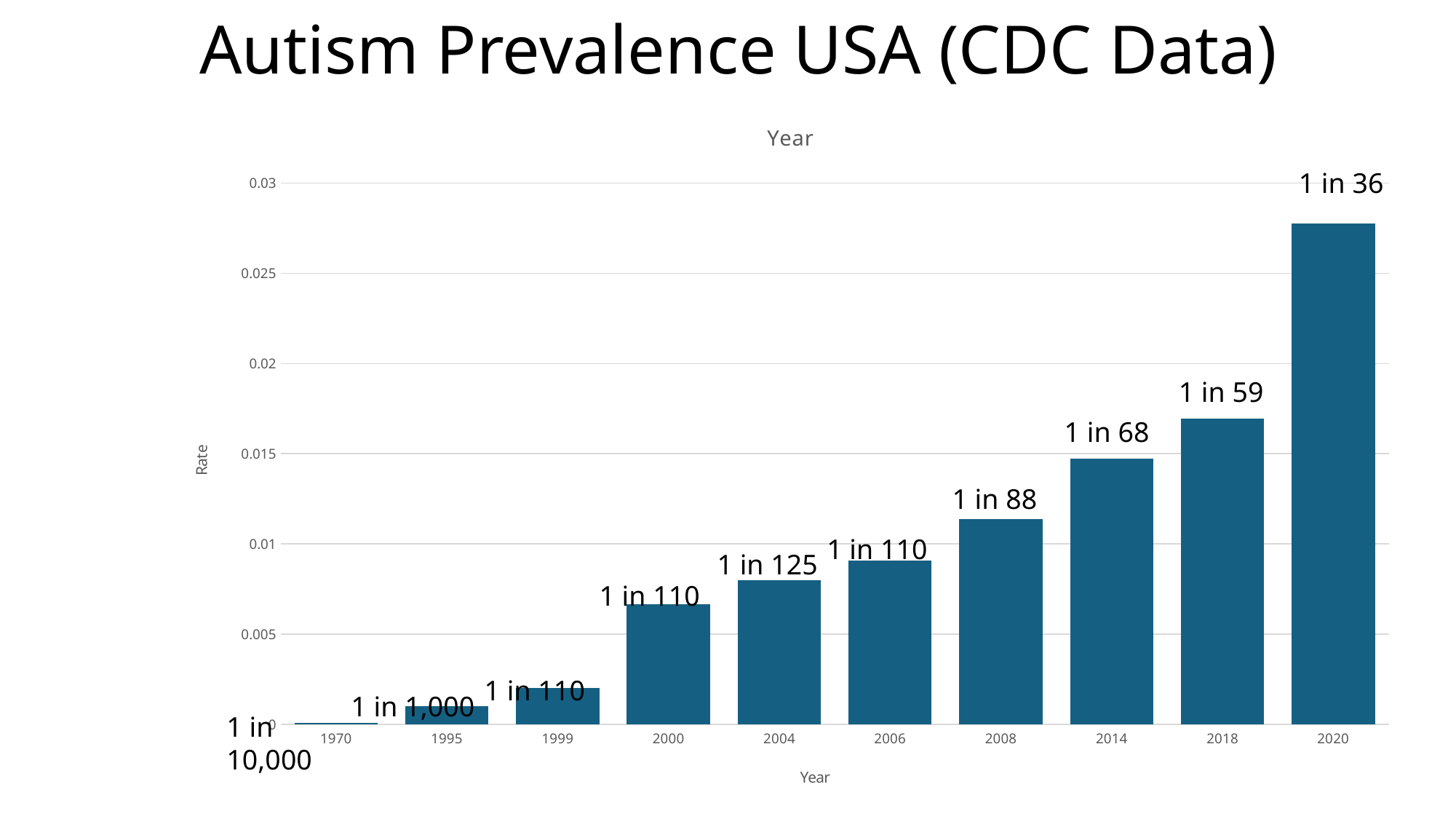
Which bar is taller, 2018 or 2014? 2018 What is the data label on the bar for 2018? 1 in 59 What is the data label on the bar for 2008? 1 in 88 How many years are shown on the x axis? 10 Which year has the tallest bar? 2020 What is the data label on the bar for 1970? 1 in 10,000 What is the data label on the bar for 2014? 1 in 68 Do the bars generally rise or fall from 1970 to 2020? Rise What kind of chart is shown on the slide? Bar chart What is the data label on the bar for 2020? 1 in 36 Is the rate for 2018 greater or less than 0.015? greater Which year has the shortest bar? 1970